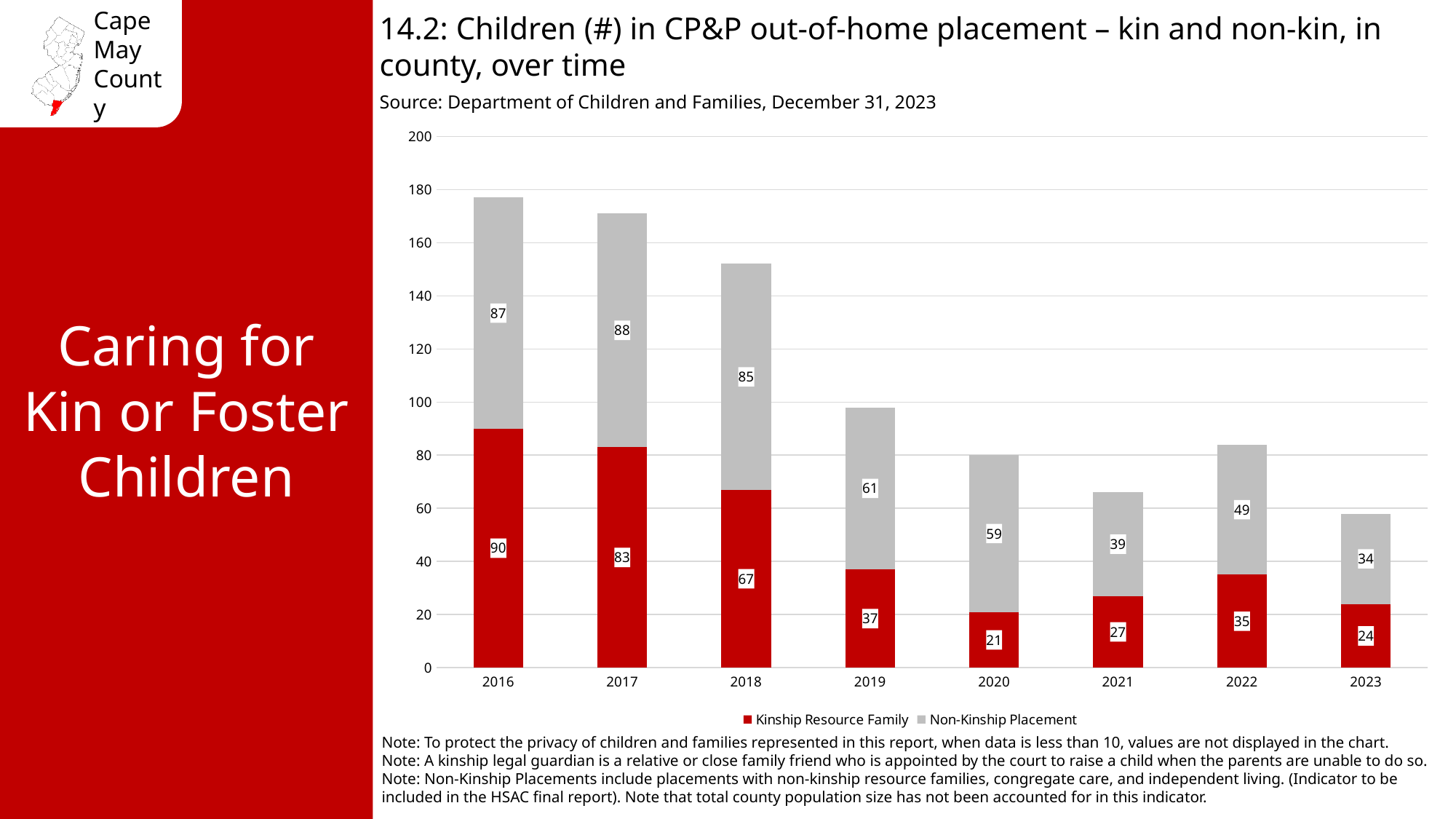
Overall, do the total bar heights rise or fall from 2016 to 2023? Fall How many series does the legend list? 2 Which is larger in 2021, the Kinship Resource Family value or the Non-Kinship Placement value? Non-Kinship Placement What is the total number of children in out-of-home placement in 2018? 152 How many years are shown on the x axis? 8 What is the Kinship Resource Family value for 2016? 90 Which year has the highest Non-Kinship Placement value? 2017 Which year has the lowest Kinship Resource Family value? 2020 What is the Non-Kinship Placement value for 2019? 61 What is the difference between the Non-Kinship Placement values for 2022 and 2023? 15 What is the Kinship Resource Family value for 2023? 24 What type of chart is shown on the slide? Stacked bar chart